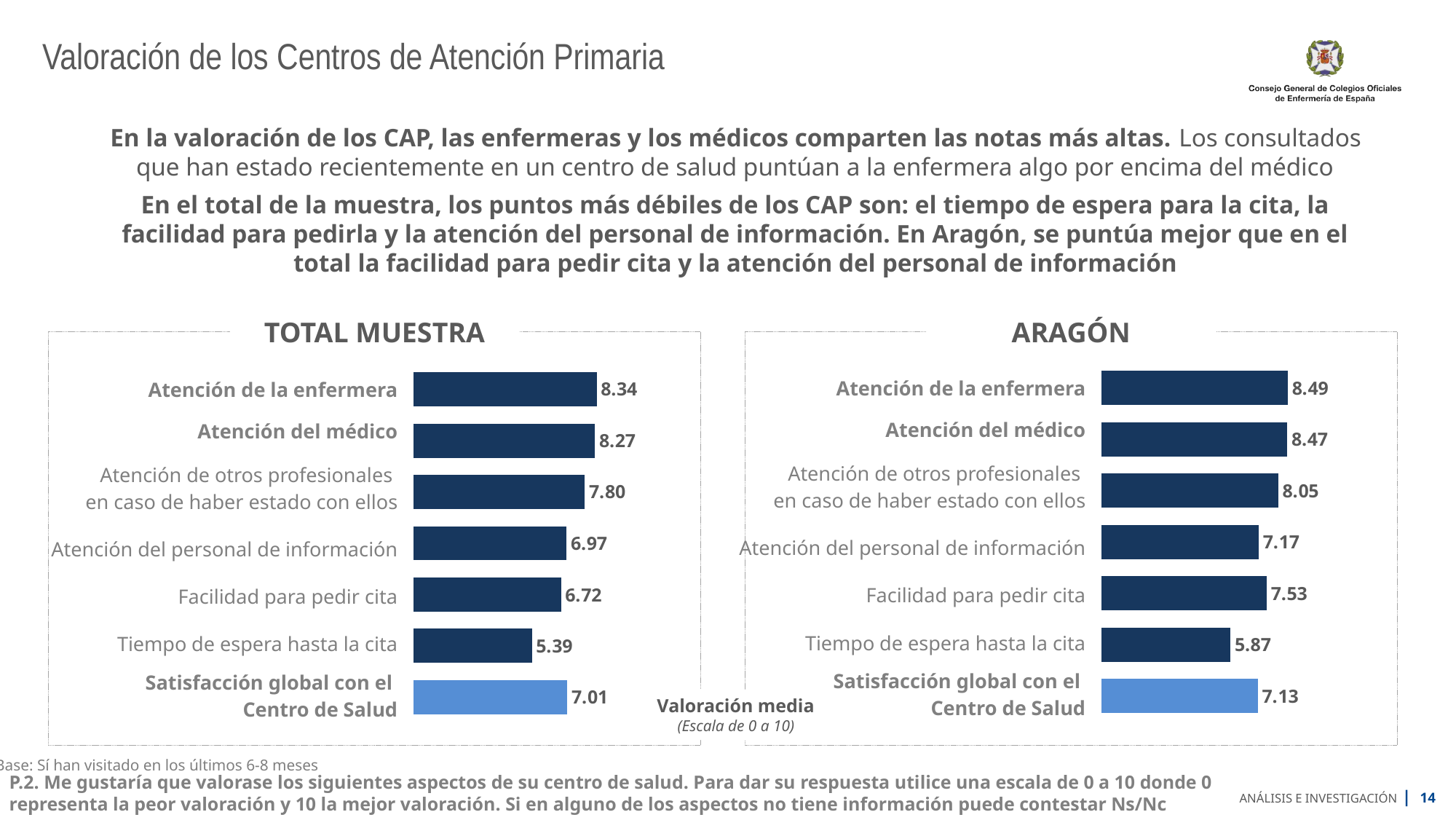
What kind of chart is the ARAGÓN chart? Bar chart In the TOTAL MUESTRA chart, which bar is shown in a lighter blue colour than the others? Satisfacción global con el Centro de Salud In the ARAGÓN chart, what is the value for Satisfacción global con el Centro de Salud? 7.13 In the TOTAL MUESTRA chart, what is the value for Atención de la enfermera? 8.34 In the TOTAL MUESTRA chart, how many categories are plotted? 7 Which is larger: Atención del personal de información in the TOTAL MUESTRA chart or in the ARAGÓN chart? ARAGÓN What scale is used for the values shown in the charts, according to the note on the slide? Escala de 0 a 10 In the TOTAL MUESTRA chart, which category has the lowest value? Tiempo de espera hasta la cita In the ARAGÓN chart, what is the difference between Facilidad para pedir cita and Tiempo de espera hasta la cita? 1.66 In the ARAGÓN chart, which category has the highest value? Atención de la enfermera In the TOTAL MUESTRA chart, what is the difference between Atención de la enfermera and Atención del médico? 0.07 In the ARAGÓN chart, what is the value for Facilidad para pedir cita? 7.53